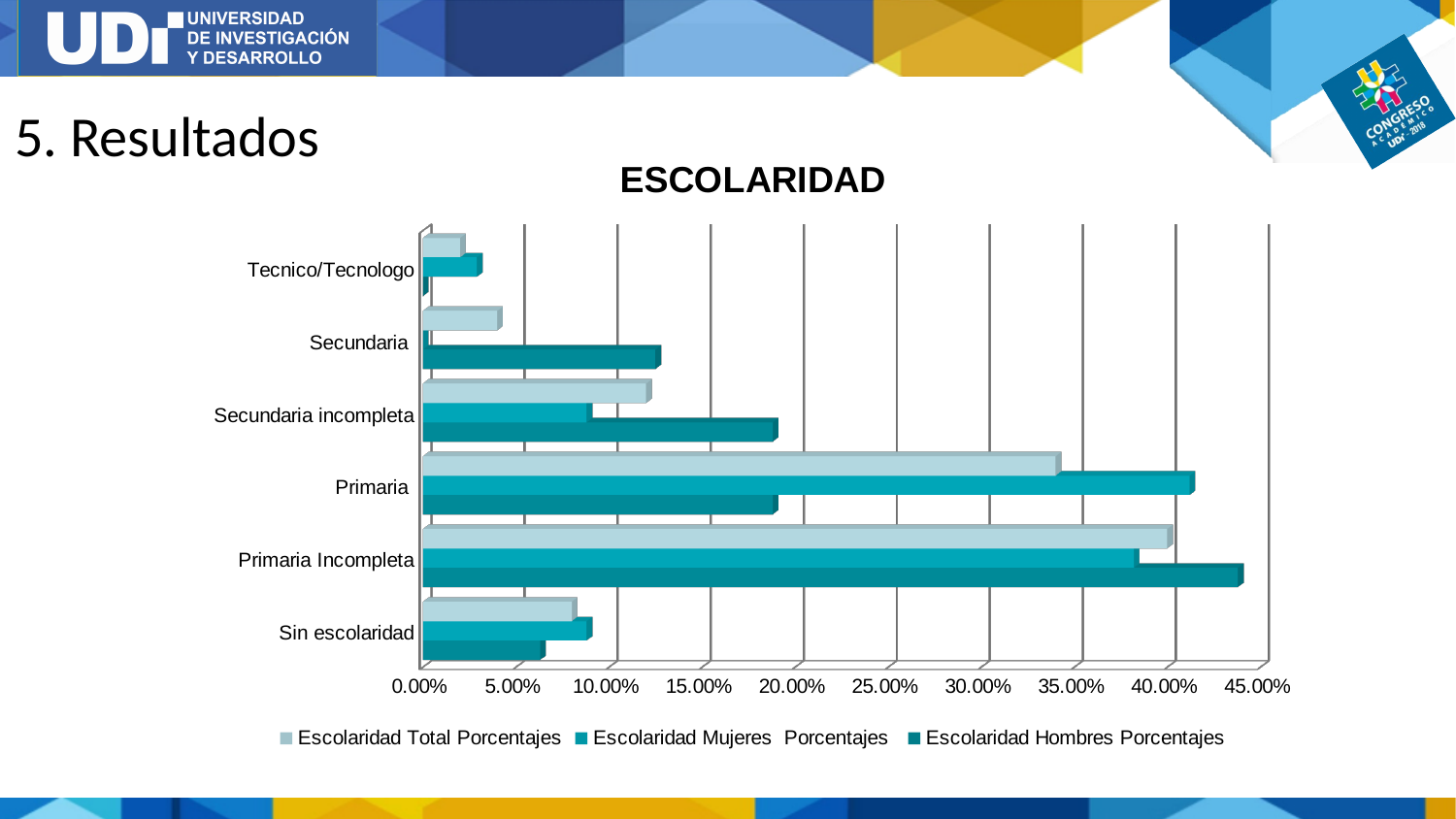
Is the value for Escolaridad Hombres Porcentajes in Primaria Incompleta greater or less than 40.00%? greater In the Primaria category, which is larger: Escolaridad Mujeres Porcentajes or Escolaridad Hombres Porcentajes? Escolaridad Mujeres Porcentajes How many education categories are shown on the y axis of the ESCOLARIDAD chart? 6 Is the value for Escolaridad Hombres Porcentajes in Secundaria greater or less than 15.00%? less What kind of chart is shown on the slide? Bar chart What is the title of the chart on the slide? ESCOLARIDAD Which category has the highest value for Escolaridad Mujeres Porcentajes? Primaria Which category has the lowest value for Escolaridad Hombres Porcentajes? Tecnico/Tecnologo Which category has the highest value for Escolaridad Total Porcentajes? Primaria Incompleta Is the value for Escolaridad Total Porcentajes in Primaria greater or less than 30.00%? greater Which category has the highest value for Escolaridad Hombres Porcentajes? Primaria Incompleta How many series does the legend of the ESCOLARIDAD chart list? 3